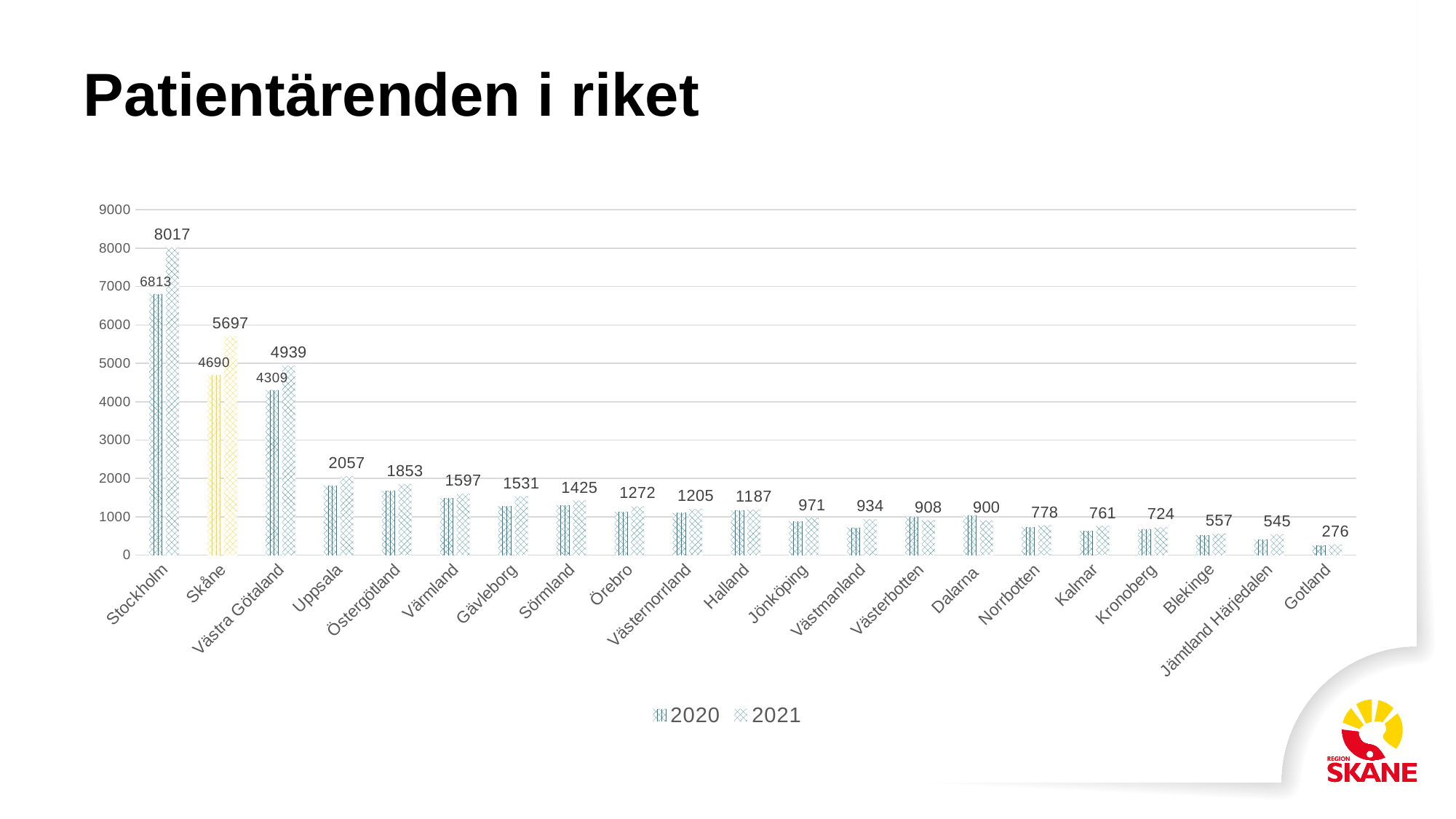
Which is larger, the 2021 value for Uppsala or the 2021 value for Östergötland? Uppsala Is the 2020 value for Uppsala greater or less than 2000? less What was the value for Västra Götaland in 2021? 4939 Which region has the lowest value in 2021? Gotland How many series does the legend list? 2 What was the value for Gotland in 2021? 276 What was the value for Stockholm in 2021? 8017 How many regions are shown on the x axis? 21 What was the value for Skåne in 2020? 4690 What is the difference between Stockholm's 2021 and 2020 values? 1204 Which region has the highest value in 2021? Stockholm What is the difference between Skåne's 2021 and 2020 values? 1007